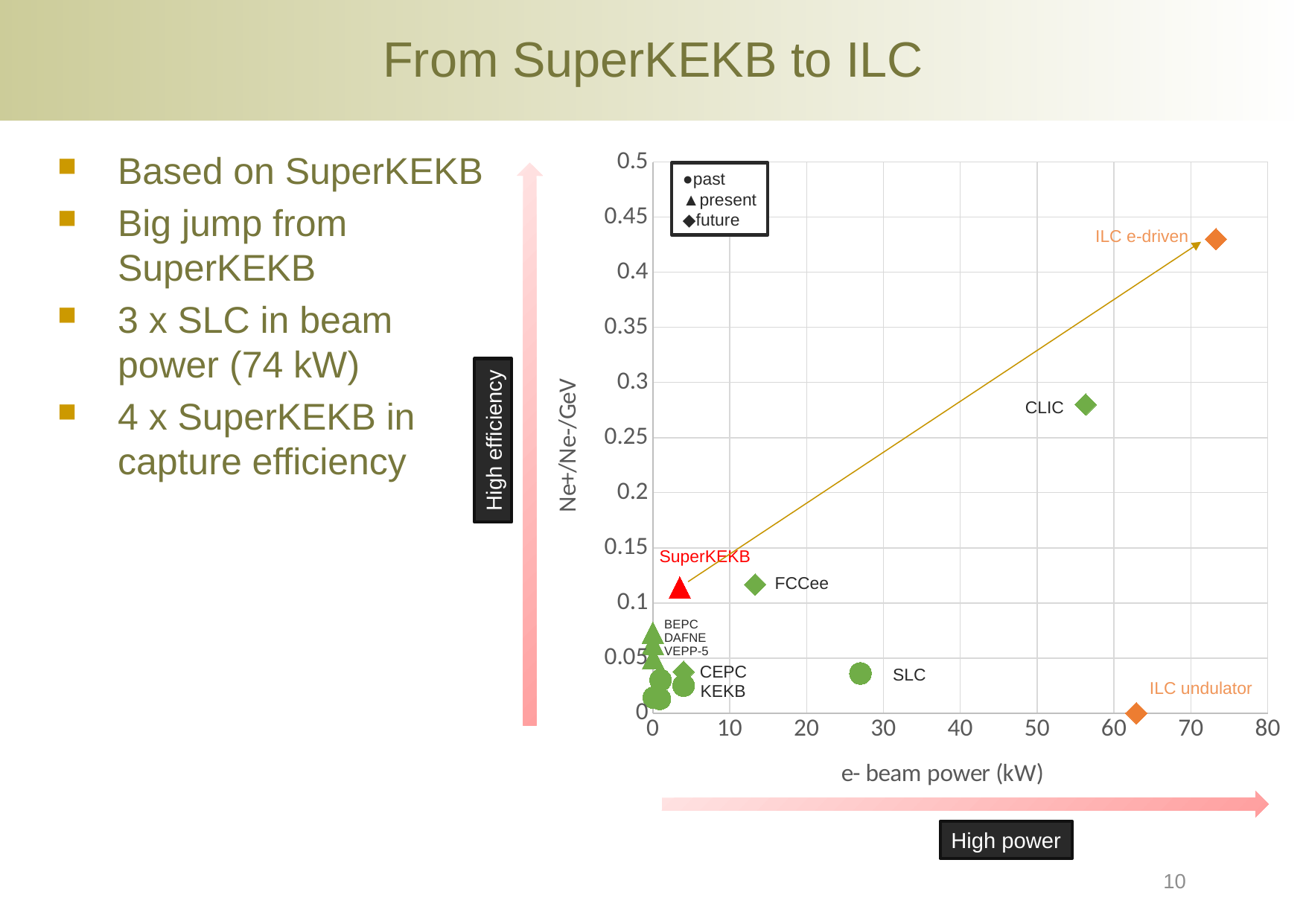
Which legend entry is represented by a diamond marker? future Is the e- beam power for CLIC greater or less than 50 kW? greater Which labelled point has the highest Ne+/Ne-/GeV value? ILC e-driven Which labelled point has the highest e- beam power? ILC e-driven What kind of chart is shown on the slide? scatter chart Which has the higher Ne+/Ne-/GeV value, CLIC or FCCee? CLIC Is the e- beam power for ILC undulator greater or less than 60 kW? greater What is the label of the x axis of the chart? e- beam power (kW) Which has the higher e- beam power, SLC or SuperKEKB? SLC How many entries does the chart legend list? 3 Is the Ne+/Ne-/GeV value for SLC greater or less than 0.05? less